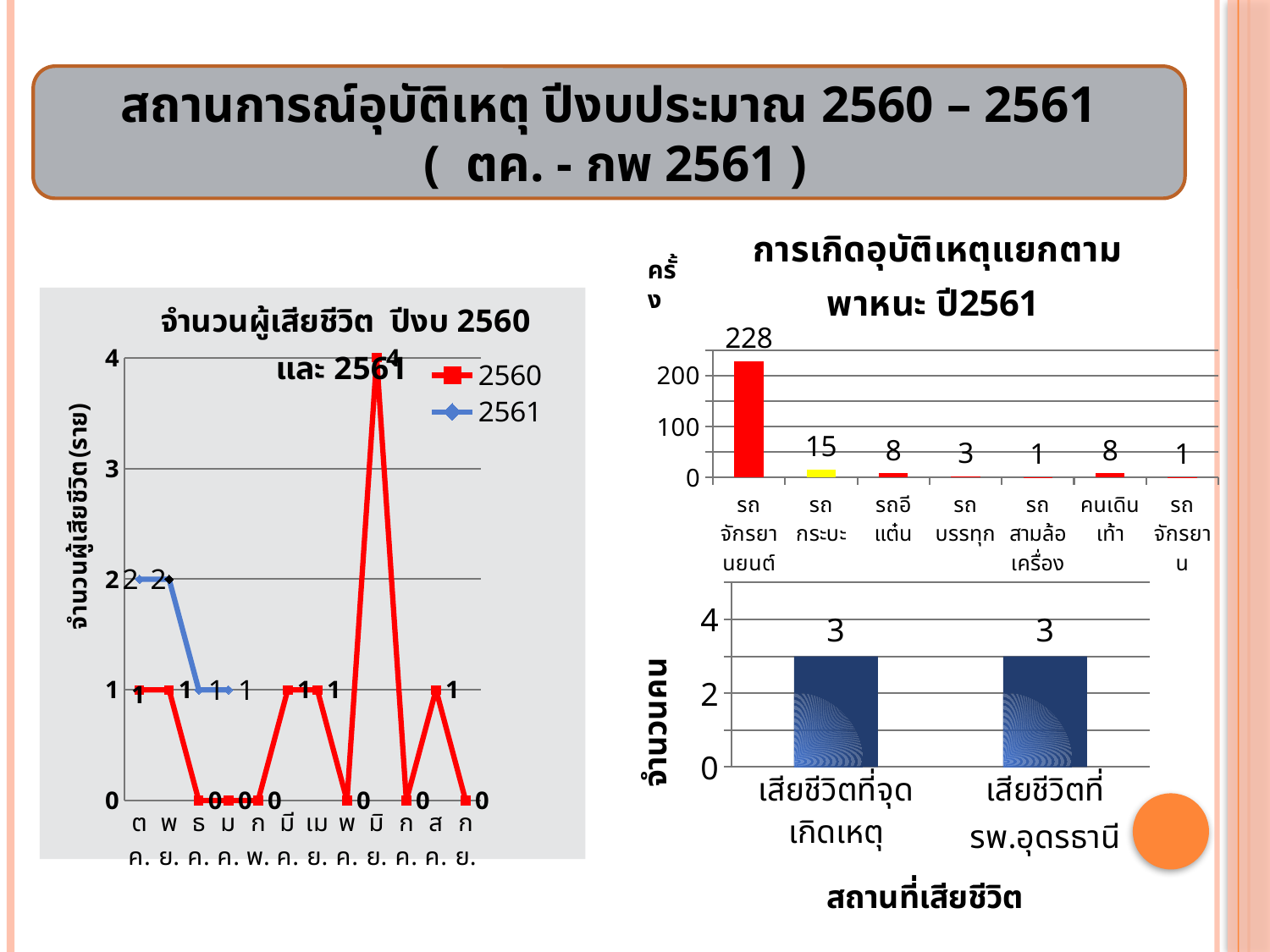
What kind of chart is the bottom-right chart with x-axis 'สถานที่เสียชีวิต'? bar chart In the chart 'จำนวนผู้เสียชีวิต ปีงบ 2560 และ 2561', what is the value for the 2561 series in ต.ค.? 2 In the chart 'จำนวนผู้เสียชีวิต ปีงบ 2560 และ 2561', what is the value for the 2560 series in มิ.ย.? 4 In the chart 'การเกิดอุบัติเหตุแยกตามพาหนะ ปี2561', what is the value for รถจักรยานยนต์? 228 What kind of chart is 'จำนวนผู้เสียชีวิต ปีงบ 2560 และ 2561'? line chart In the chart 'การเกิดอุบัติเหตุแยกตามพาหนะ ปี2561', which is larger, the value for รถบรรทุก or the value for คนเดินเท้า? คนเดินเท้า In the chart 'การเกิดอุบัติเหตุแยกตามพาหนะ ปี2561', what is the value for รถกระบะ? 15 In the chart 'การเกิดอุบัติเหตุแยกตามพาหนะ ปี2561', what is the difference between the values for รถกระบะ and รถอีแต๋น? 7 In the bottom-right chart with x-axis 'สถานที่เสียชีวิต', what is the value for เสียชีวิตที่ รพ.อุดรธานี? 3 In the chart 'จำนวนผู้เสียชีวิต ปีงบ 2560 และ 2561', how many series does the legend list? 2 In the chart 'การเกิดอุบัติเหตุแยกตามพาหนะ ปี2561', how many vehicle categories are shown? 7 In the chart 'การเกิดอุบัติเหตุแยกตามพาหนะ ปี2561', which vehicle category has the highest value? รถจักรยานยนต์